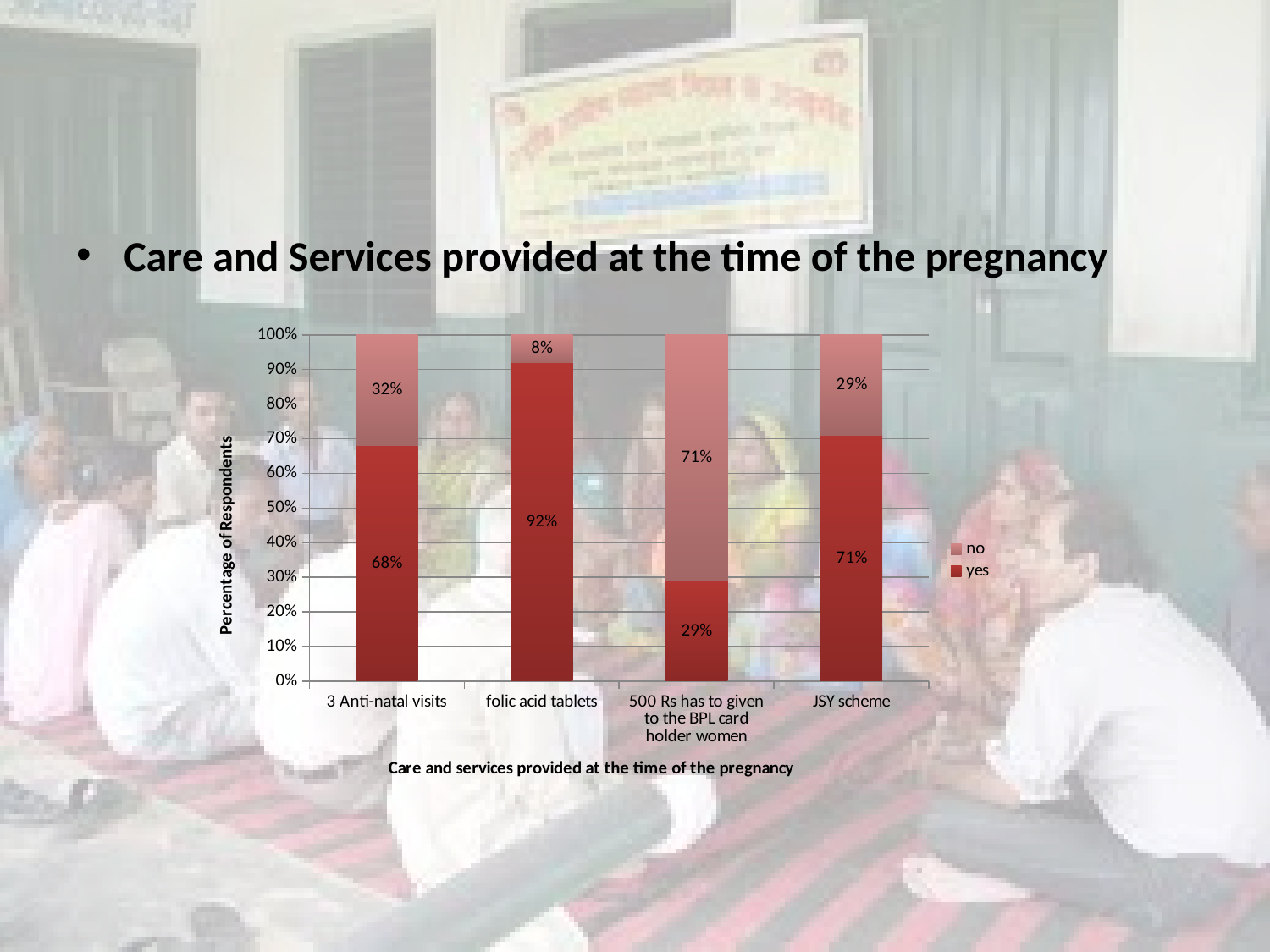
What percentage of respondents answered "yes" for 3 Anti-natal visits? 68% What is the difference between the "yes" values for folic acid tablets and 3 Anti-natal visits? 24% Which category has the lowest "yes" percentage? 500 Rs has to given to the BPL card holder women Which is larger: the "no" value for 3 Anti-natal visits or the "no" value for JSY scheme? 3 Anti-natal visits What is the title of the vertical axis? Percentage of Respondents What is the "no" value for JSY scheme? 29% What is the "yes" value for 500 Rs has to given to the BPL card holder women? 29% How many categories are shown on the x axis? 4 How many series does the legend list? 2 Which category has the highest "yes" percentage? folic acid tablets What kind of chart is shown on the slide? Stacked bar chart What percentage of respondents answered "no" for folic acid tablets? 8%